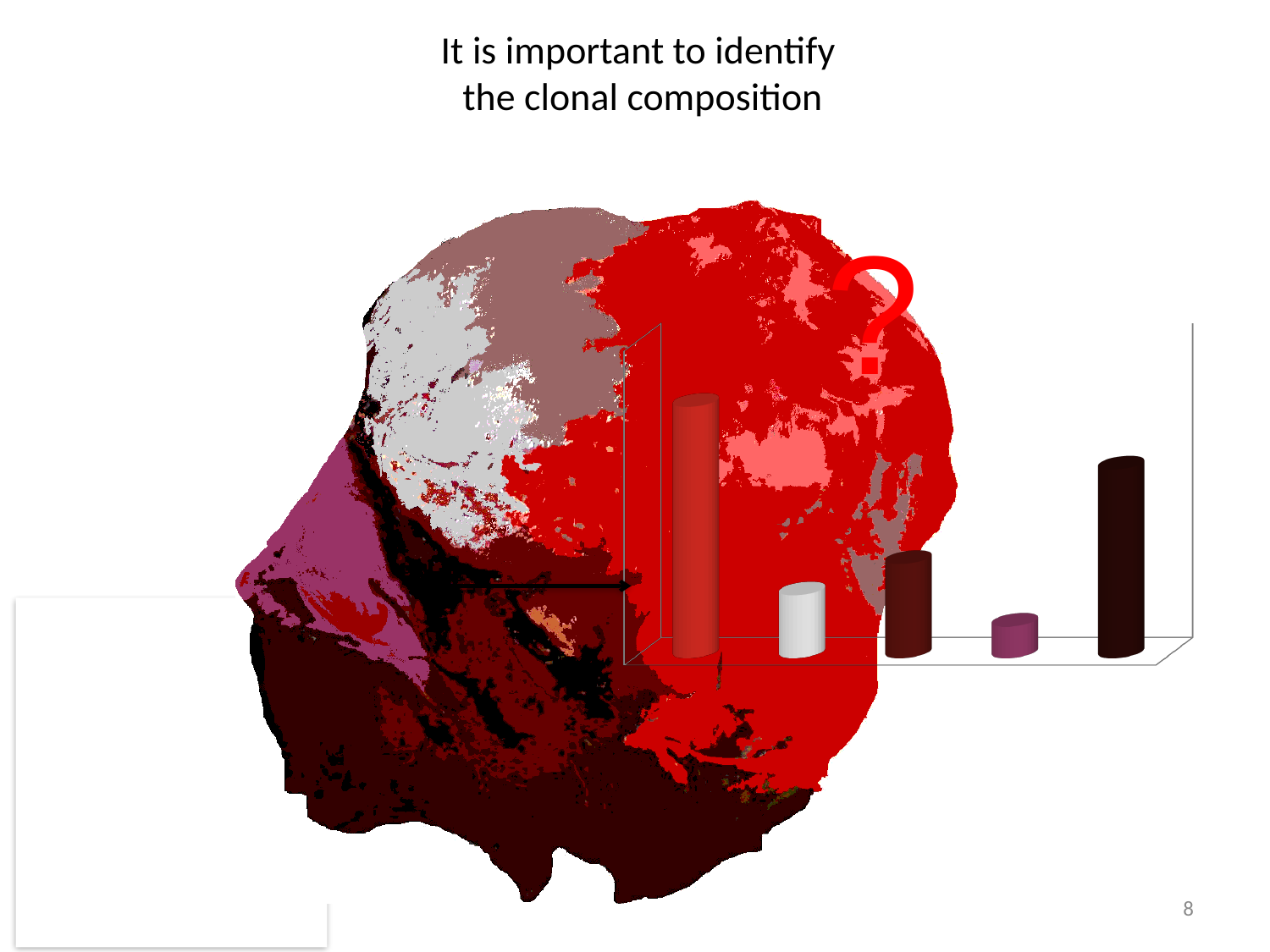
Which bar in the chart is the tallest: the first (red) bar from the left or the last (dark) bar on the right? the first (red) bar Is the second bar from the left (white) taller or shorter than the third bar from the left (dark red)? shorter What kind of chart is shown on the slide? bar chart How many bars does the chart on the slide contain? 5 Which bar in the chart is the shortest, by its position from the left? the fourth bar (purple) What colour is the tallest bar in the chart? red Which bar in the chart is the tallest, by its position from the left? the first bar (red) Is the fifth bar from the left (dark) taller or shorter than the third bar from the left (dark red)? taller Does the chart on the slide display a legend? No